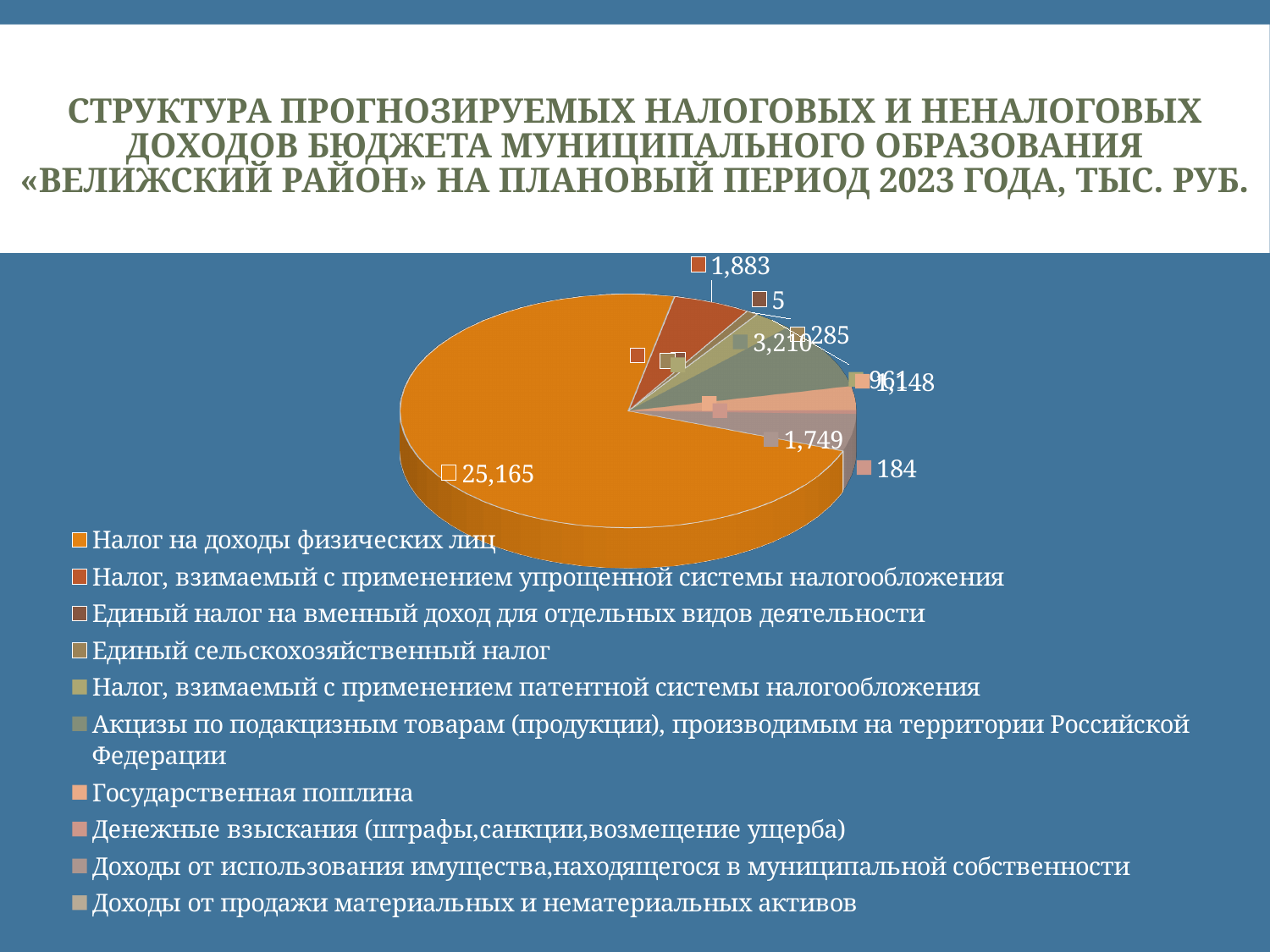
What kind of chart is shown on the slide? pie chart What is the value for Налог, взимаемый с применением упрощенной системы налогообложения? 1,883 What is the value for Налог на доходы физических лиц? 25,165 In what units are the values in the chart expressed, according to the slide title? тыс. руб. Which category has the largest slice of the pie? Налог на доходы физических лиц What is the difference between the value for Налог, взимаемый с применением упрощенной системы налогообложения (1,883) and the value for Единый налог на вменный доход для отдельных видов деятельности (5)? 1,878 Which is larger: the value for Налог, взимаемый с применением упрощенной системы налогообложения or the value for Единый налог на вменный доход для отдельных видов деятельности? Налог, взимаемый с применением упрощенной системы налогообложения What colour is the slice for Налог на доходы физических лиц? orange How many categories does the legend list? 10 What is the value for Единый налог на вменный доход для отдельных видов деятельности? 5